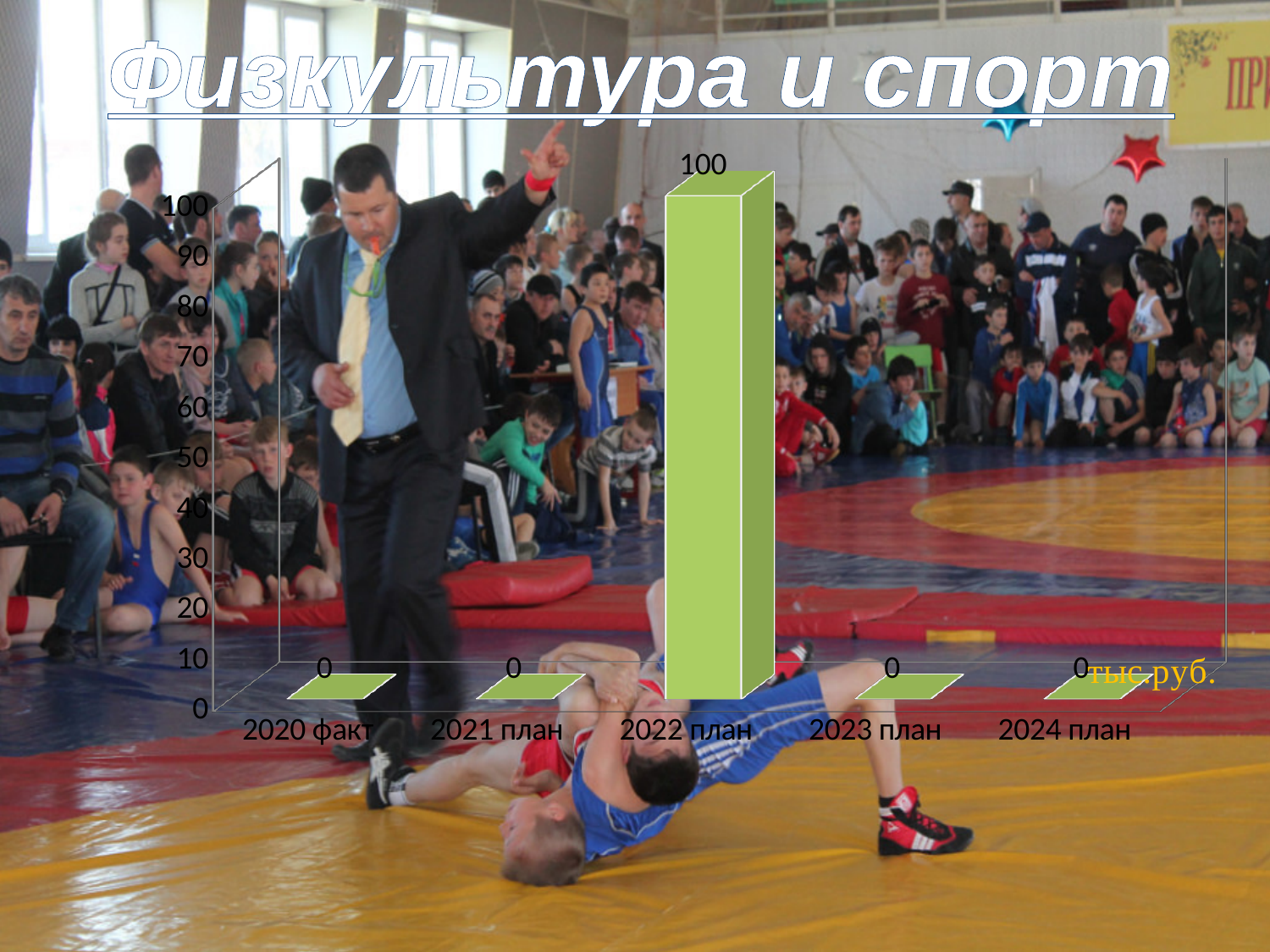
Which category has the highest value? 2022 план Which is larger, the value for 2022 план or the value for 2023 план? 2022 план What is the highest value shown on the vertical axis? 100 Is the value for 2022 план greater or less than 50? greater What is the value for 2022 план? 100 What unit label is shown next to the chart? тыс.руб. What is the difference between the values for 2022 план and 2021 план? 100 What is the value for 2020 факт? 0 How many categories are shown on the x axis? 5 What kind of chart is shown on the slide? bar chart What is the value for 2024 план? 0 What is the value for 2023 план? 0